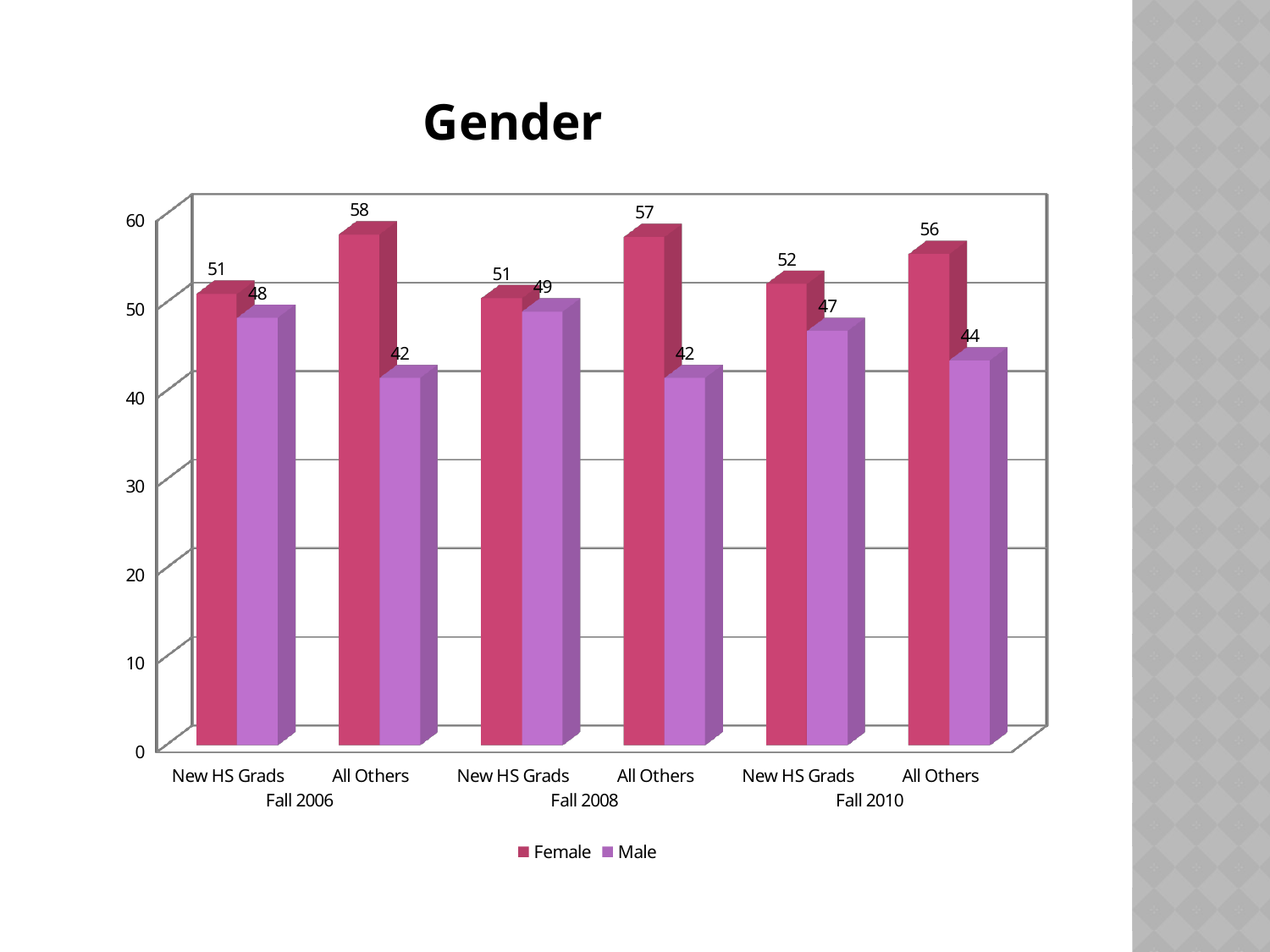
What is the Male value for New HS Grads in Fall 2010? 47 What is the Female value for All Others in Fall 2010? 56 Which category has the lowest Male value? All Others (Fall 2006 and Fall 2008, both 42) How many series does the legend list? 2 What is the title of the chart? Gender What kind of chart is shown on the slide? Bar chart What is the difference between the Female and Male values for All Others in Fall 2006? 16 Which is larger: the Male value for New HS Grads in Fall 2008 or the Male value for New HS Grads in Fall 2010? New HS Grads in Fall 2008 What is the Female value for New HS Grads in Fall 2006? 51 What is the Male value for All Others in Fall 2008? 42 How many categories are shown on the x axis? 6 Which category has the highest Female value? All Others, Fall 2006